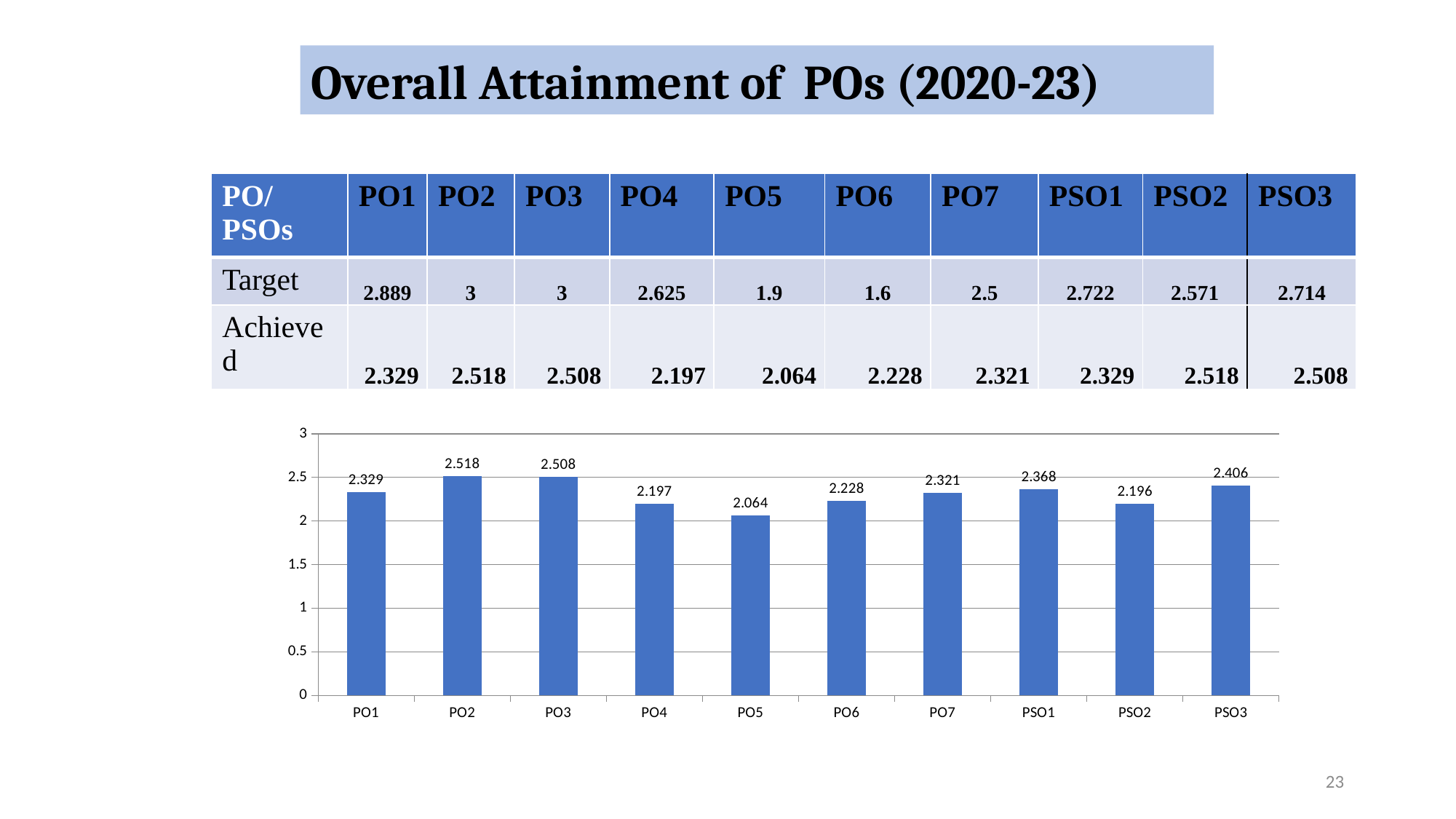
In the chart, which is larger, the value for PSO1 or the value for PSO2? PSO1 What is the highest tick value shown on the chart's vertical axis? 3 What kind of chart is shown on the slide? bar chart How many categories are plotted on the x axis of the chart? 10 What is the value shown for PO5 in the chart? 2.064 What is the value shown for PSO3 in the chart? 2.406 Which category has the highest value in the chart? PO2 Is the value for PO5 in the chart greater or less than 2.5? less What is the value shown for PO1 in the chart? 2.329 Which category has the lowest value in the chart? PO5 In the chart, what is the difference between the values for PO2 and PO1? 0.189 What is the value shown for PSO2 in the chart? 2.196